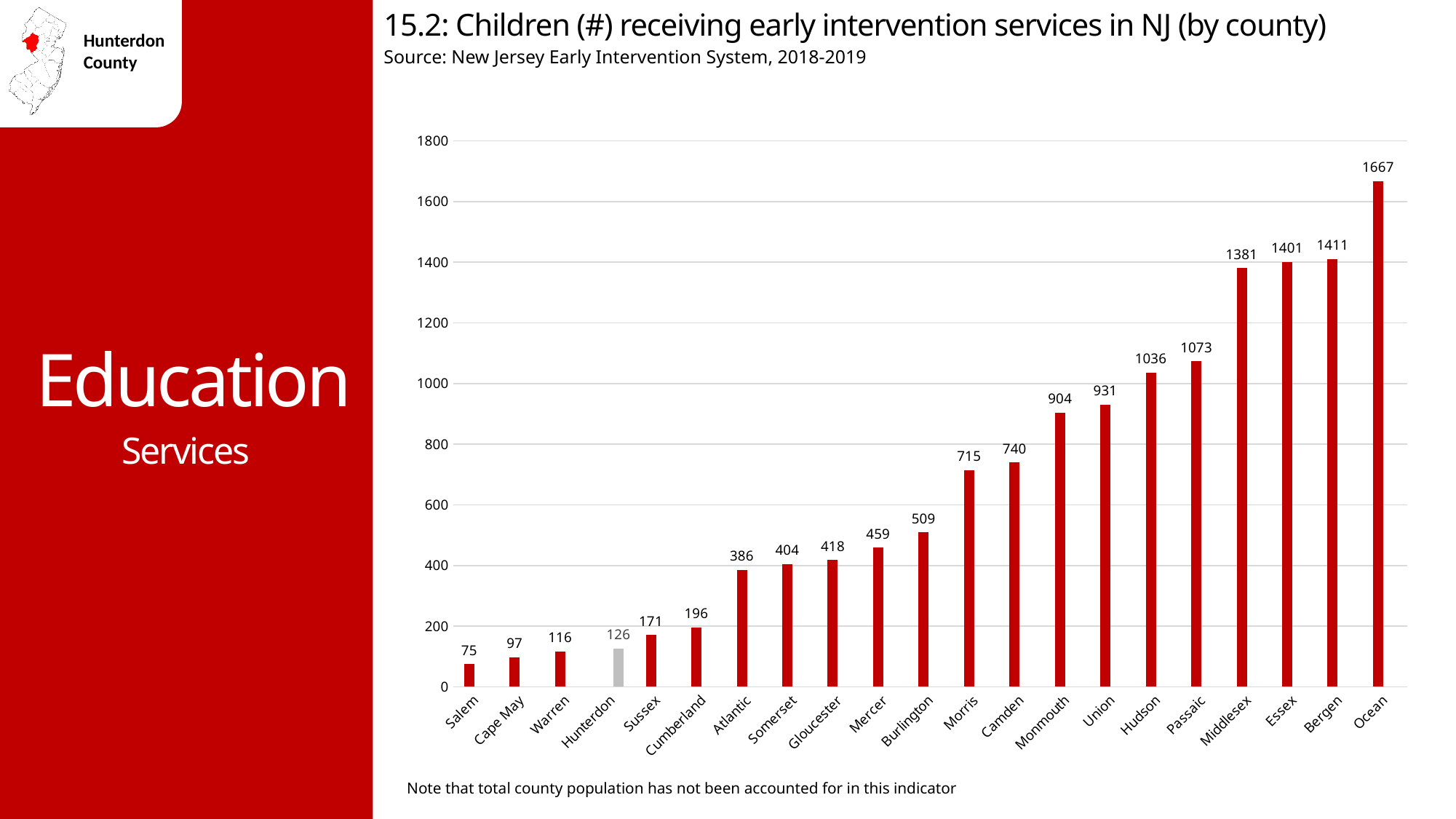
Which county has a larger value, Morris or Camden? Camden How many counties are shown on the chart? 21 What is the value shown for Ocean County? 1667 Which county has the highest number of children receiving early intervention services? Ocean What is the difference between the values for Bergen and Essex? 10 Which county's bar is coloured grey instead of red? Hunterdon What is the difference between the values for Ocean and Salem? 1592 What is the value shown for Mercer County? 459 How many children received early intervention services in Hunterdon County? 126 Is the value for Hudson greater or less than 1000? greater Which county has the lowest number of children receiving early intervention services? Salem What kind of chart is shown on the slide? Bar chart